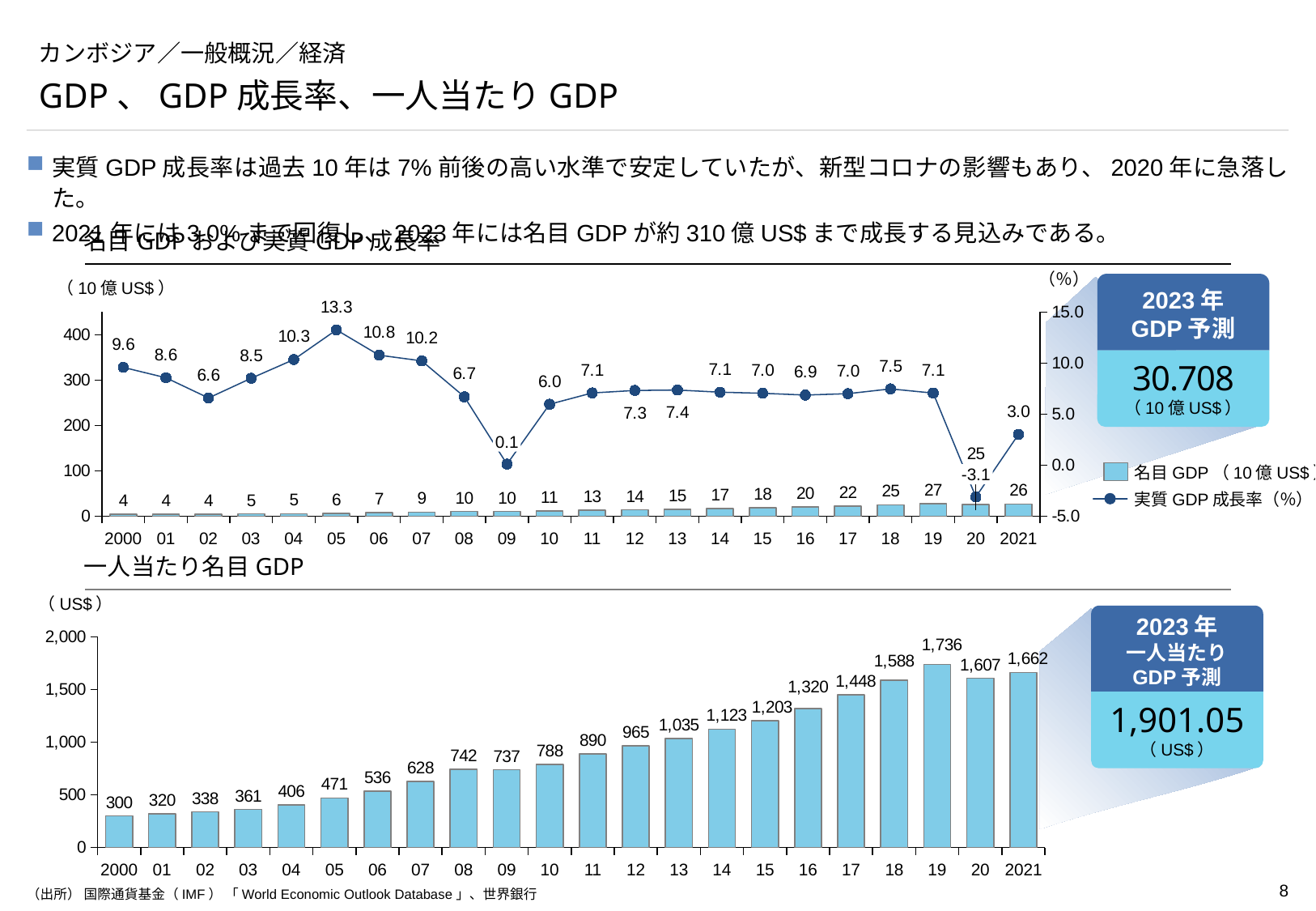
In the top chart (名目GDPおよび実質GDP成長率), what is the nominal GDP (名目GDP) value for 2019? 27 In the top chart (名目GDPおよび実質GDP成長率), which year has the lowest real GDP growth rate? 20 In the top chart (名目GDPおよび実質GDP成長率), what is the real GDP growth rate (実質GDP成長率) for 2005? 13.3 In the bottom chart (一人当たり名目GDP), what is the difference between the values for 2021 and 2020? 55 In the top chart (名目GDPおよび実質GDP成長率), what is the difference between the nominal GDP values for 2019 and 2020? 2 In the bottom chart (一人当たり名目GDP), is the value for 2008 larger or smaller than the value for 2009? larger In the bottom chart (一人当たり名目GDP), what is the value for 2019? 1,736 In the top chart (名目GDPおよび実質GDP成長率), what is the real GDP growth rate for 2021? 3.0 In the bottom chart (一人当たり名目GDP), which year has the highest value? 19 In the top chart (名目GDPおよび実質GDP成長率), how many series does the legend list? 2 What kind of chart is the bottom chart (一人当たり名目GDP)? bar chart In the bottom chart (一人当たり名目GDP), which year has the lowest value? 2000